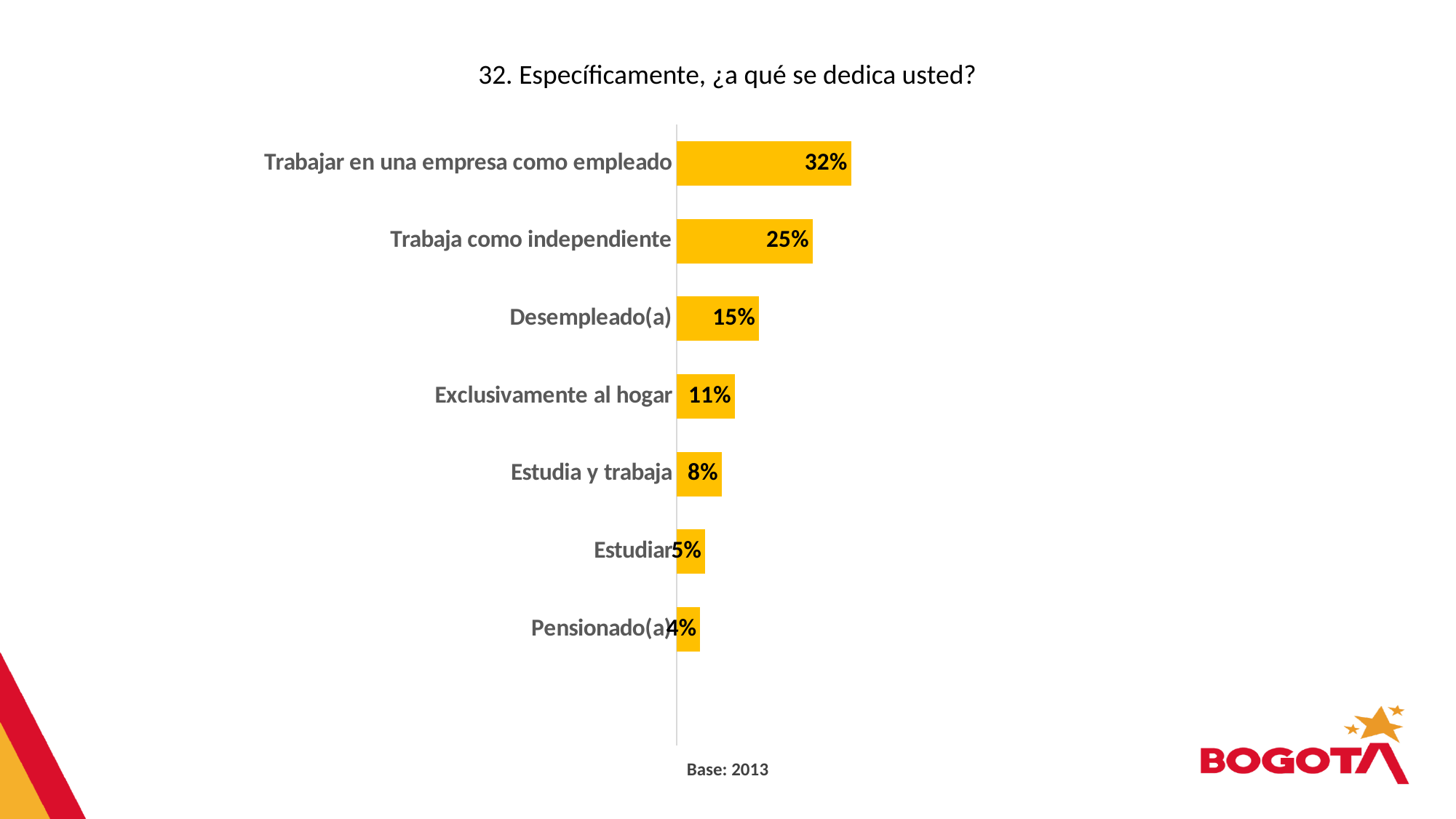
What is the value for 'Pensionado(a)'? 4% Which category has the highest value? Trabajar en una empresa como empleado Which is larger, 'Desempleado(a)' or 'Exclusivamente al hogar'? Desempleado(a) Which category has the lowest value? Pensionado(a) What percentage is shown for 'Exclusivamente al hogar'? 11% What is the difference between 'Estudia y trabaja' and 'Estudiar'? 3% What is the difference between 'Trabajar en una empresa como empleado' and 'Trabaja como independiente'? 7% What percentage of respondents answered 'Trabajar en una empresa como empleado'? 32% What is the value shown for 'Desempleado(a)'? 15% What is the title of the chart? 32. Específicamente, ¿a qué se dedica usted? What kind of chart is shown on the slide? Bar chart How many categories are shown in the chart? 7